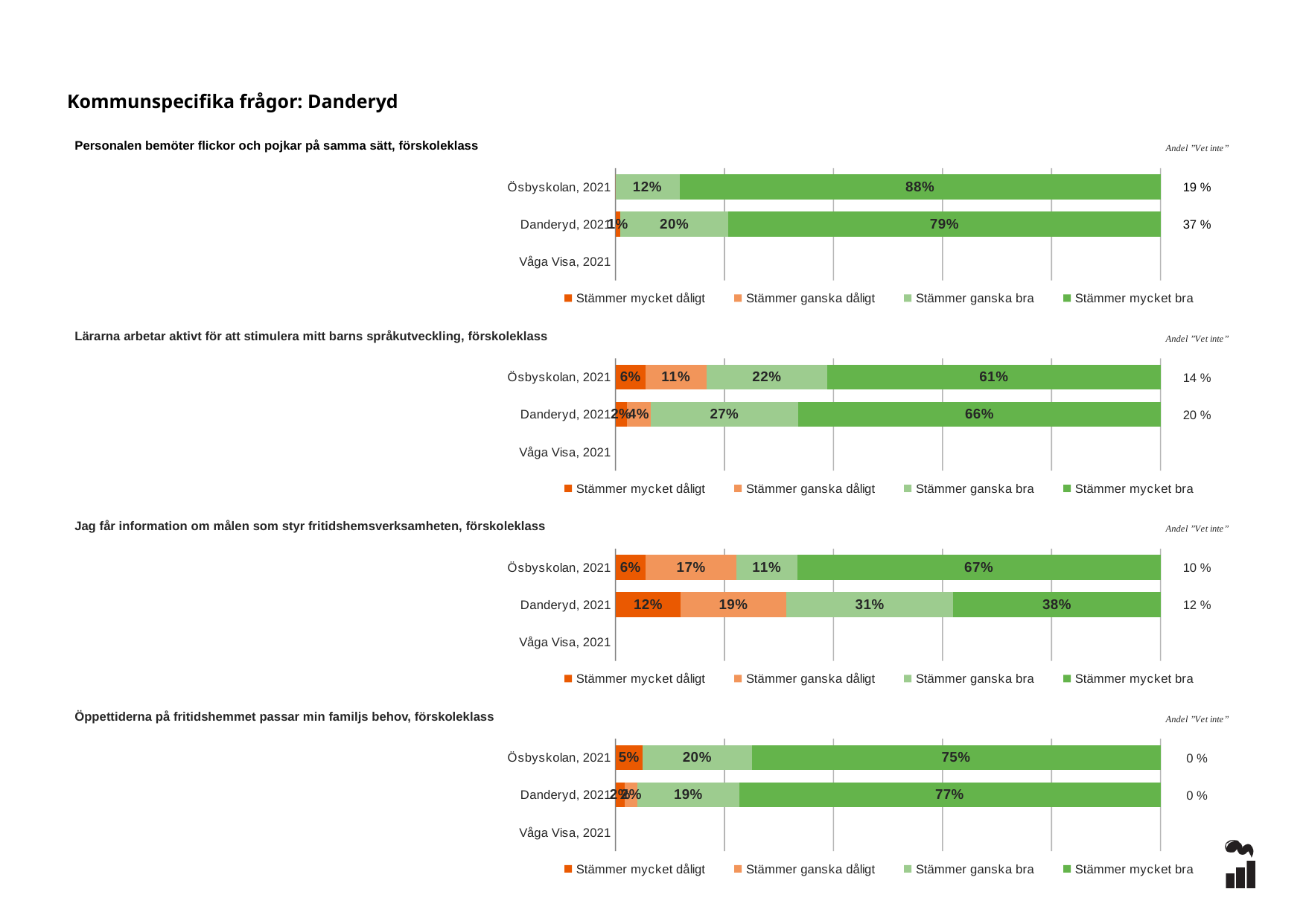
In the chart 'Öppettiderna på fritidshemmet passar min familjs behov, förskoleklass', what is the 'Stämmer mycket bra' value for Danderyd, 2021? 77% In the chart 'Öppettiderna på fritidshemmet passar min familjs behov, förskoleklass', what is the 'Stämmer ganska bra' value for Ösbyskolan, 2021? 20% In the chart 'Personalen bemöter flickor och pojkar på samma sätt, förskoleklass', what is the 'Andel Vet inte' value shown for Danderyd, 2021? 37 % In the chart 'Personalen bemöter flickor och pojkar på samma sätt, förskoleklass', what is the 'Stämmer mycket bra' value for Ösbyskolan, 2021? 88% In the chart 'Lärarna arbetar aktivt för att stimulera mitt barns språkutveckling, förskoleklass', what is the 'Stämmer mycket bra' value for Danderyd, 2021? 66% In the chart 'Jag får information om målen som styr fritidshemsverksamheten, förskoleklass', what is the difference between the 'Stämmer mycket bra' values for Ösbyskolan, 2021 and Danderyd, 2021? 29% What kind of chart is 'Öppettiderna på fritidshemmet passar min familjs behov, förskoleklass'? Stacked bar chart In the chart 'Lärarna arbetar aktivt för att stimulera mitt barns språkutveckling, förskoleklass', what is the 'Stämmer ganska dåligt' value for Ösbyskolan, 2021? 11% In the chart 'Jag får information om målen som styr fritidshemsverksamheten, förskoleklass', which has the larger 'Stämmer mycket bra' value, Ösbyskolan, 2021 or Danderyd, 2021? Ösbyskolan, 2021 How many series does the legend list in the chart 'Lärarna arbetar aktivt för att stimulera mitt barns språkutveckling, förskoleklass'? 4 In the chart 'Personalen bemöter flickor och pojkar på samma sätt, förskoleklass', what is the 'Stämmer ganska bra' value for Danderyd, 2021? 20% In the chart 'Jag får information om målen som styr fritidshemsverksamheten, förskoleklass', what is the 'Stämmer mycket dåligt' value for Danderyd, 2021? 12%